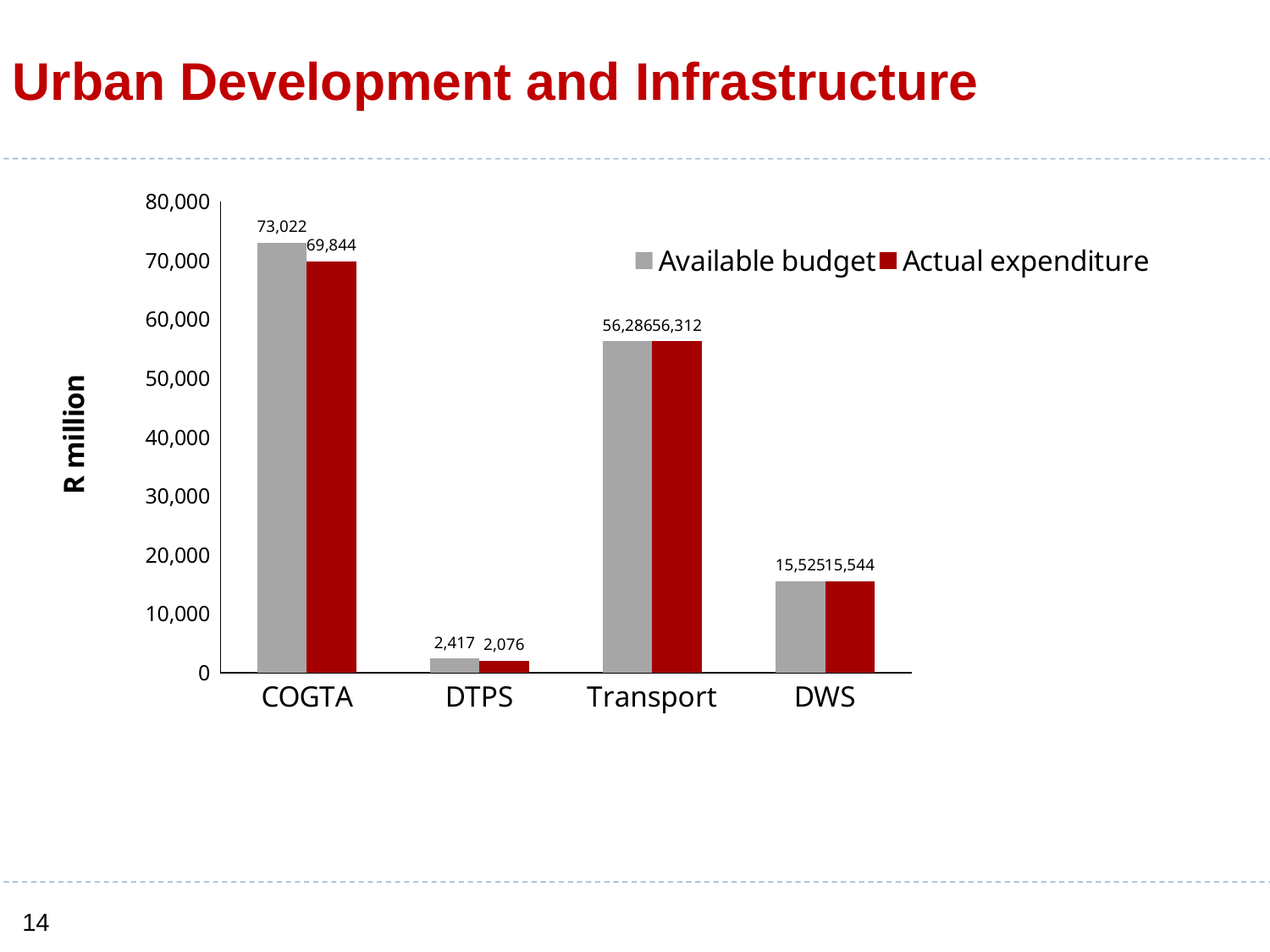
What is the Actual expenditure for DTPS? 2,076 What is the Available budget for DTPS? 2,417 What kind of chart is shown on the slide? Bar chart How many series does the legend list? 2 Which category has the highest Available budget? COGTA What is the Available budget for COGTA? 73,022 How many categories are shown on the x axis? 4 Which category has the lowest Actual expenditure? DTPS What is the difference between the Available budget and the Actual expenditure for COGTA? 3,178 For COGTA, which is larger: the Available budget or the Actual expenditure? Available budget Is the Available budget for Transport greater or less than 50,000? greater What is the Actual expenditure for COGTA? 69,844